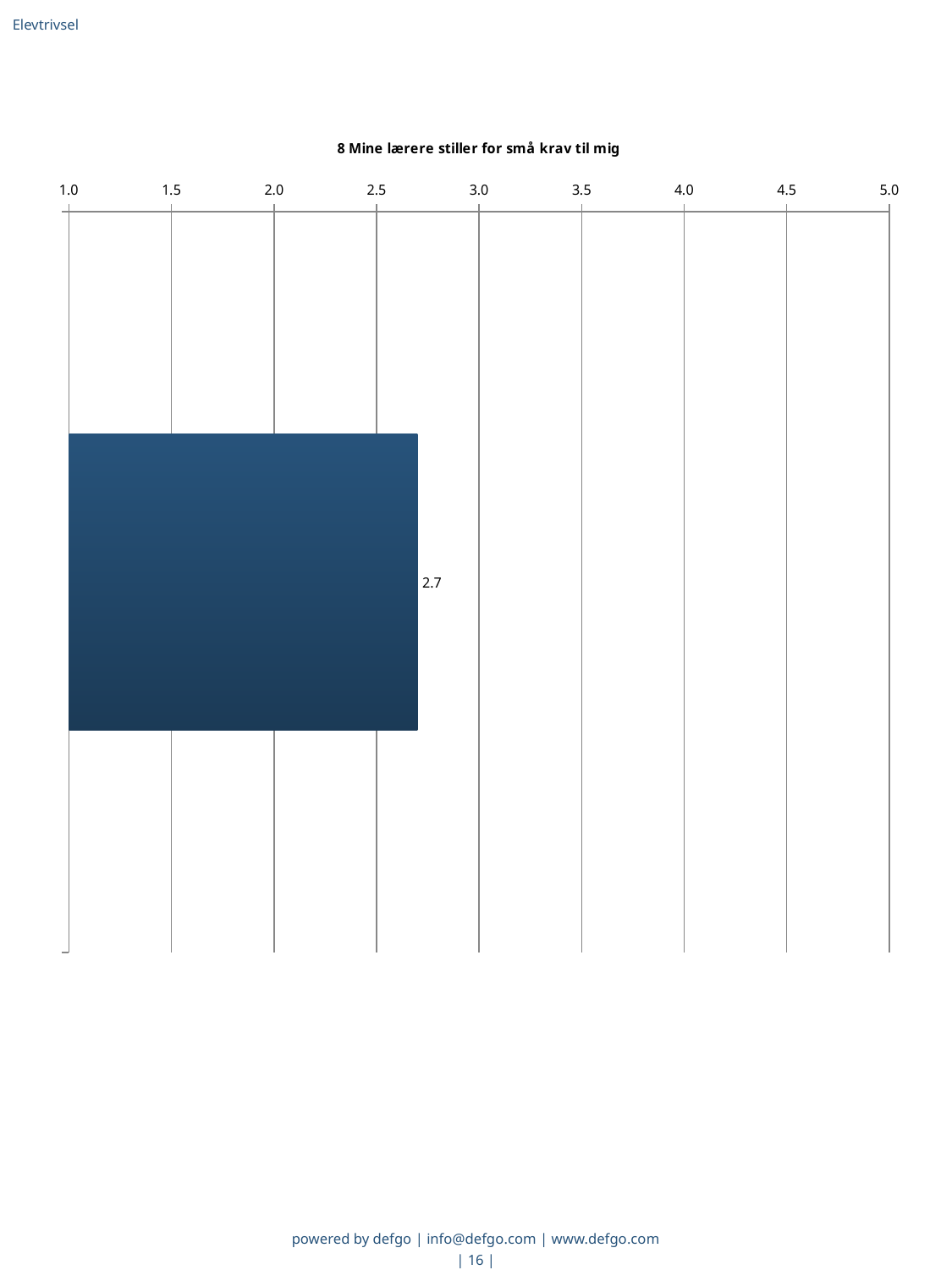
What value is shown by the data label on the bar in the chart? 2.7 What kind of chart is shown on the slide? bar chart What is the highest value shown on the chart's axis? 5.0 Is the value of the bar greater or less than 2.5? greater Is the value of the bar greater or less than 3.0? less What is the title of the chart? 8 Mine lærere stiller for små krav til mig Is the value of the bar greater or less than 2.0? greater How many bars are plotted in the chart? 1